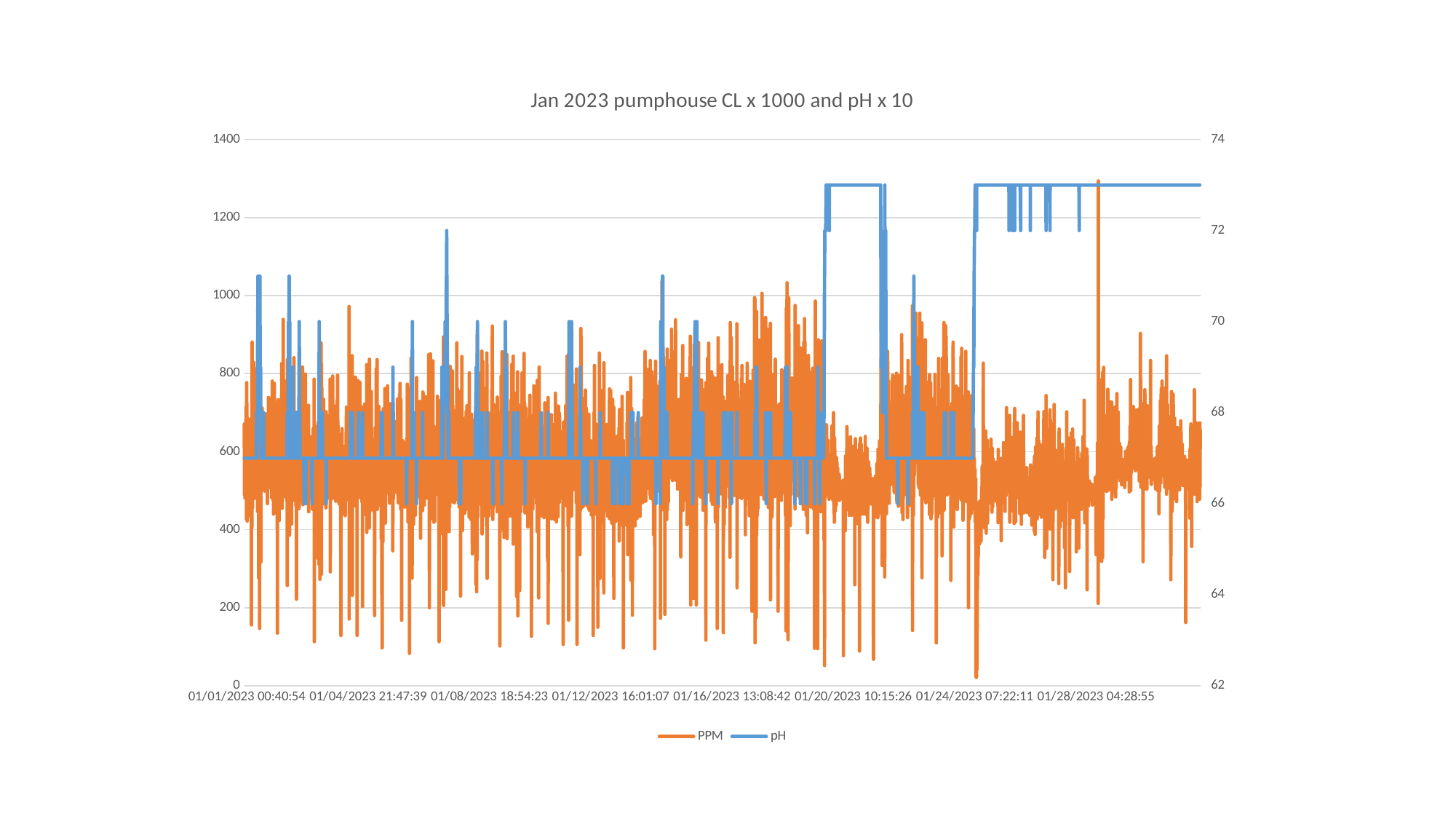
Is the highest value of the PPM series (left axis) greater or less than 1200? greater Is the highest value of the pH series (right axis) greater or less than 72? greater Which series is plotted in orange? PPM How many date labels are shown along the x axis? 8 What kind of chart is shown on the slide? line chart What is the title of the chart? Jan 2023 pumphouse CL x 1000 and pH x 10 How many series does the legend list? 2 Which colour is used for the pH series? blue Does the pH series end higher or lower than it starts? higher Is the pH value at the far right end of the chart greater or less than 72? greater